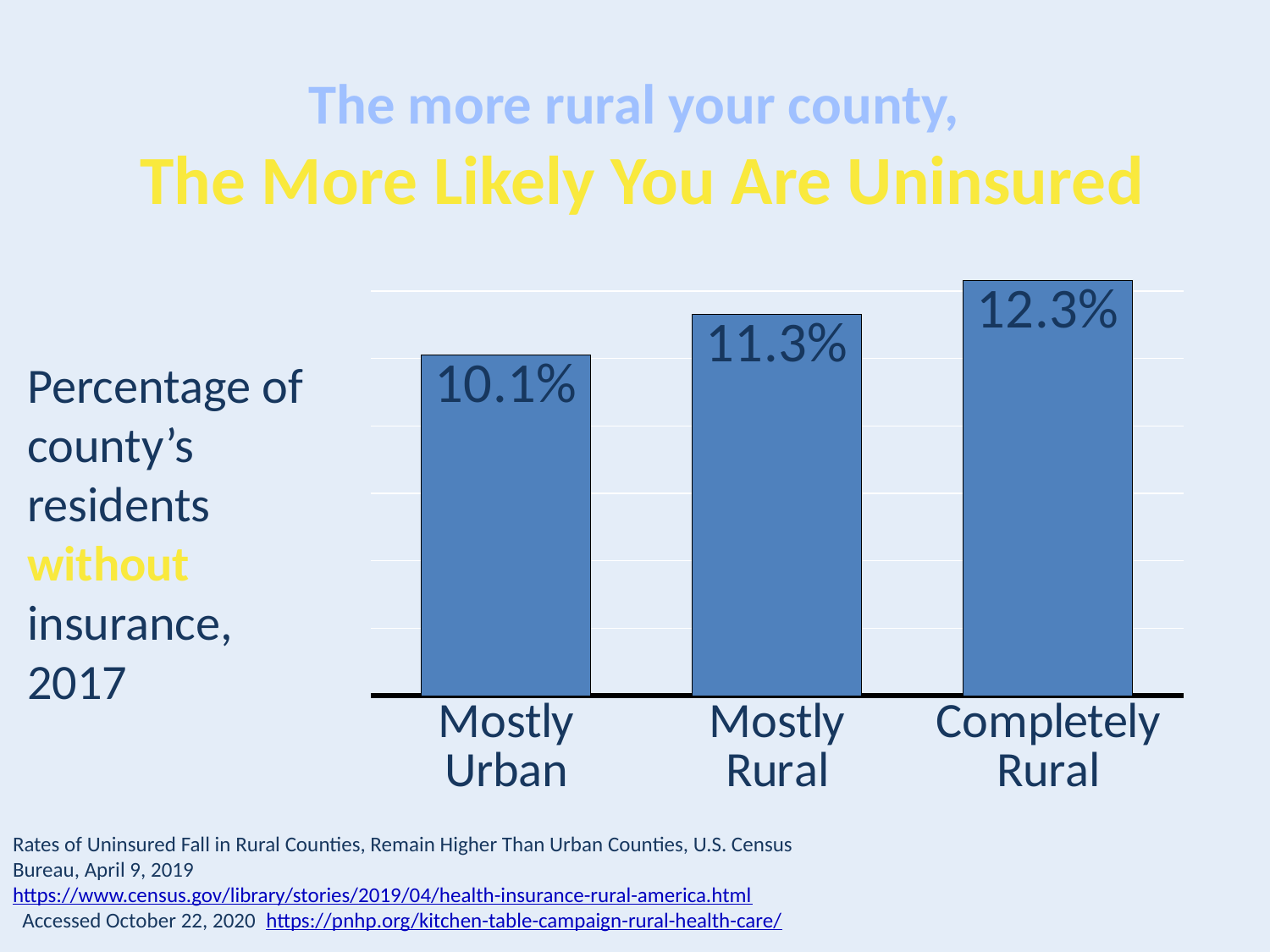
What is the percentage of residents without insurance for Mostly Urban counties? 10.1% What is the difference in uninsured percentage between Completely Rural and Mostly Urban counties? 2.2% Which has a higher uninsured percentage, Mostly Rural or Completely Rural counties? Completely Rural Which county category has the highest percentage of residents without insurance? Completely Rural How many county categories are shown in the chart? 3 What is the percentage of residents without insurance for Mostly Rural counties? 11.3% What is the difference in uninsured percentage between Mostly Rural and Mostly Urban counties? 1.2% What is the percentage of residents without insurance for Completely Rural counties? 12.3% What kind of chart is shown on the slide? Bar chart What year does the chart's data on uninsured residents refer to? 2017 Do the uninsured percentages rise or fall moving from Mostly Urban to Completely Rural? Rise Which county category has the lowest percentage of residents without insurance? Mostly Urban